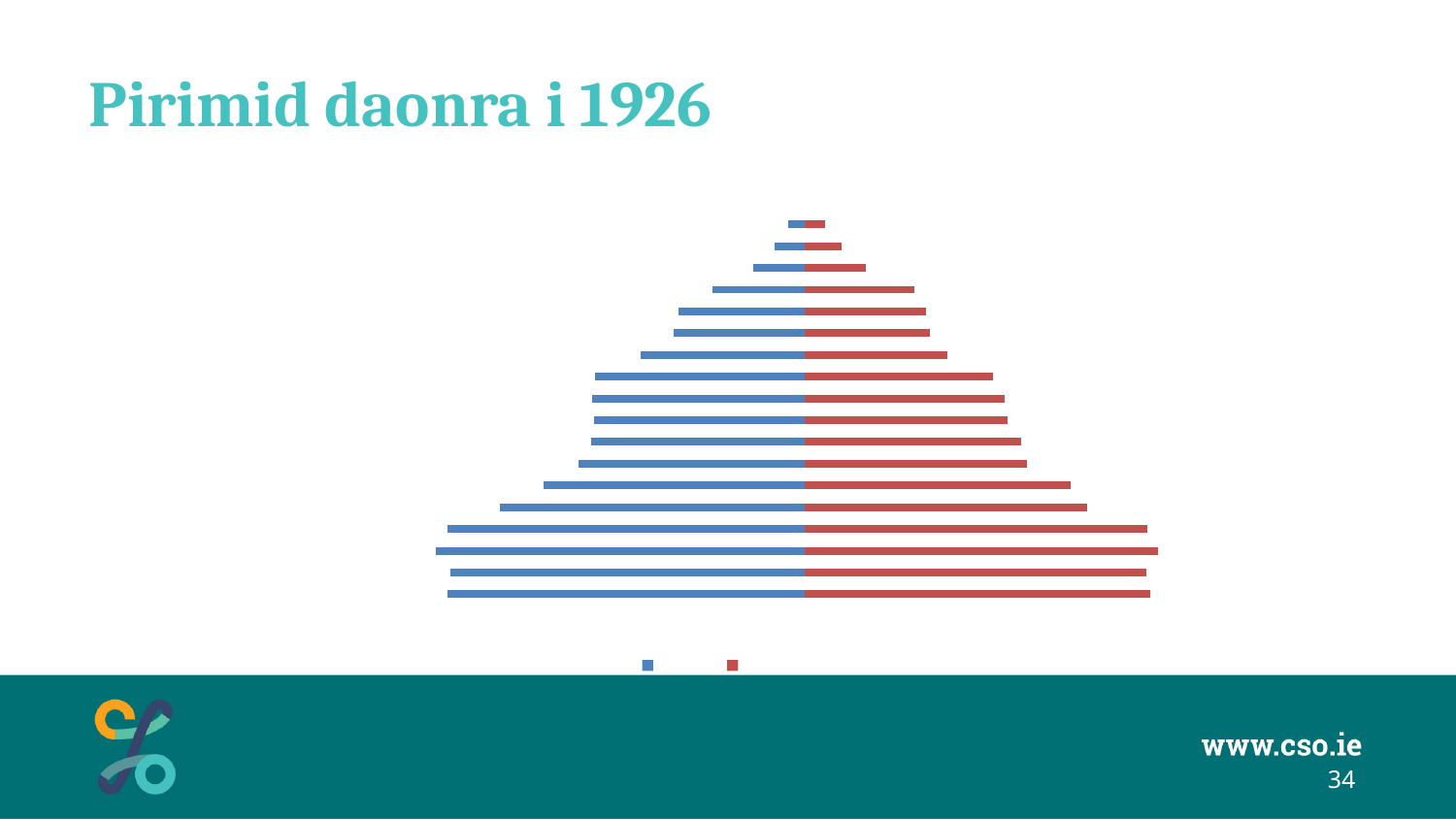
Going from the top of the pyramid to the bottom, do the bars generally get longer or shorter? longer How many series does the legend list? 2 What is the title of the chart on the slide? Pirimid daonra i 1926 What kind of chart is shown on the slide? bar chart What two colours are used for the bars in the chart? blue and red How many rows of bars does the chart have? 18